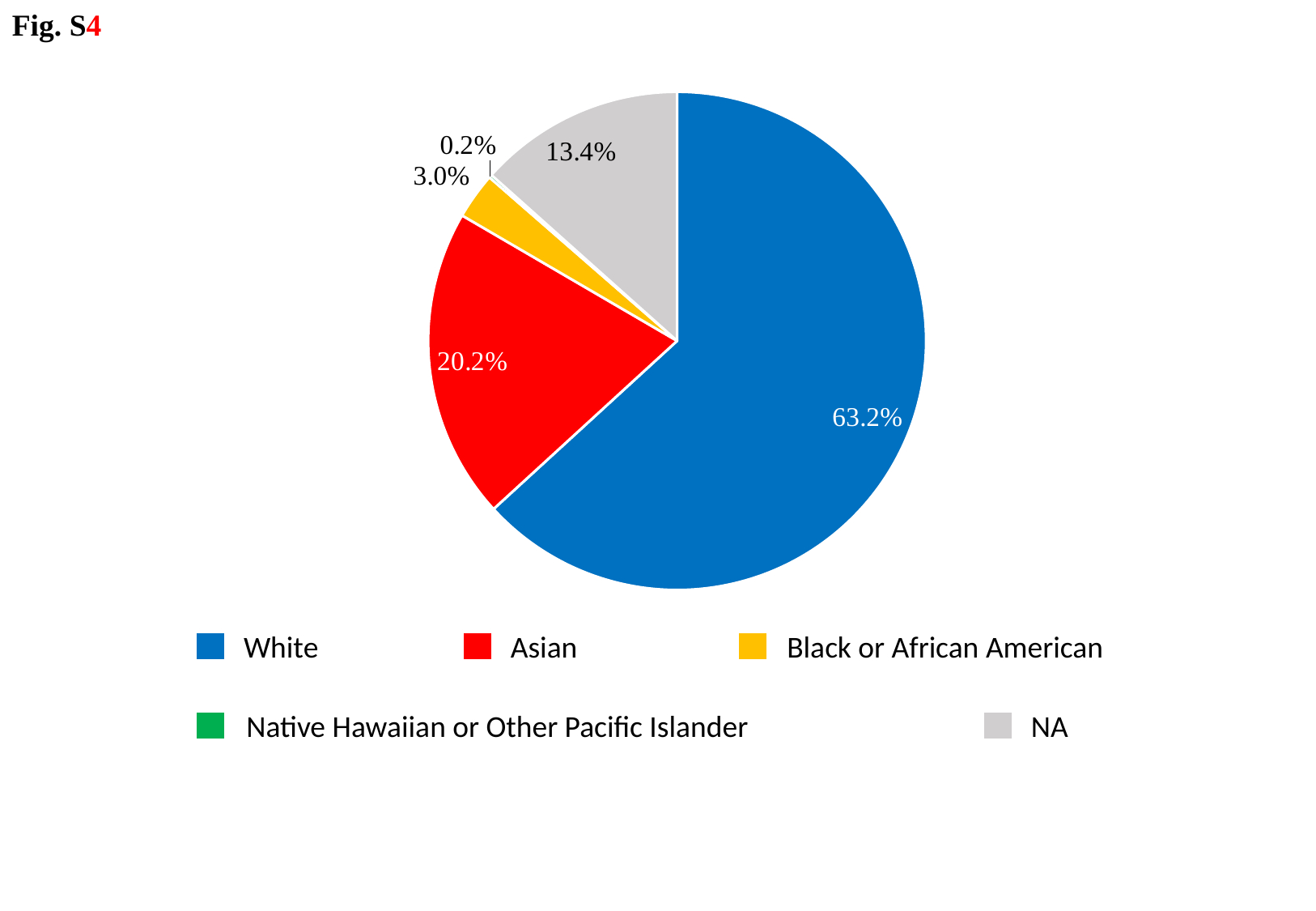
What colour is used for the NA slice? grey Which category has the smallest share of the pie? Native Hawaiian or Other Pacific Islander How many categories does the legend list? 5 Which is larger, the Asian slice or the NA slice? Asian What is the value shown for the NA slice? 13.4% What is the value shown for the Asian slice? 20.2% What is the difference in percentage points between the White and Asian slices? 43.0 What is the value shown for the Native Hawaiian or Other Pacific Islander slice? 0.2% What type of chart is shown on the slide? pie chart What is the value shown for the Black or African American slice? 3.0% What percentage of the pie does the White slice represent? 63.2% Which category has the largest share of the pie? White